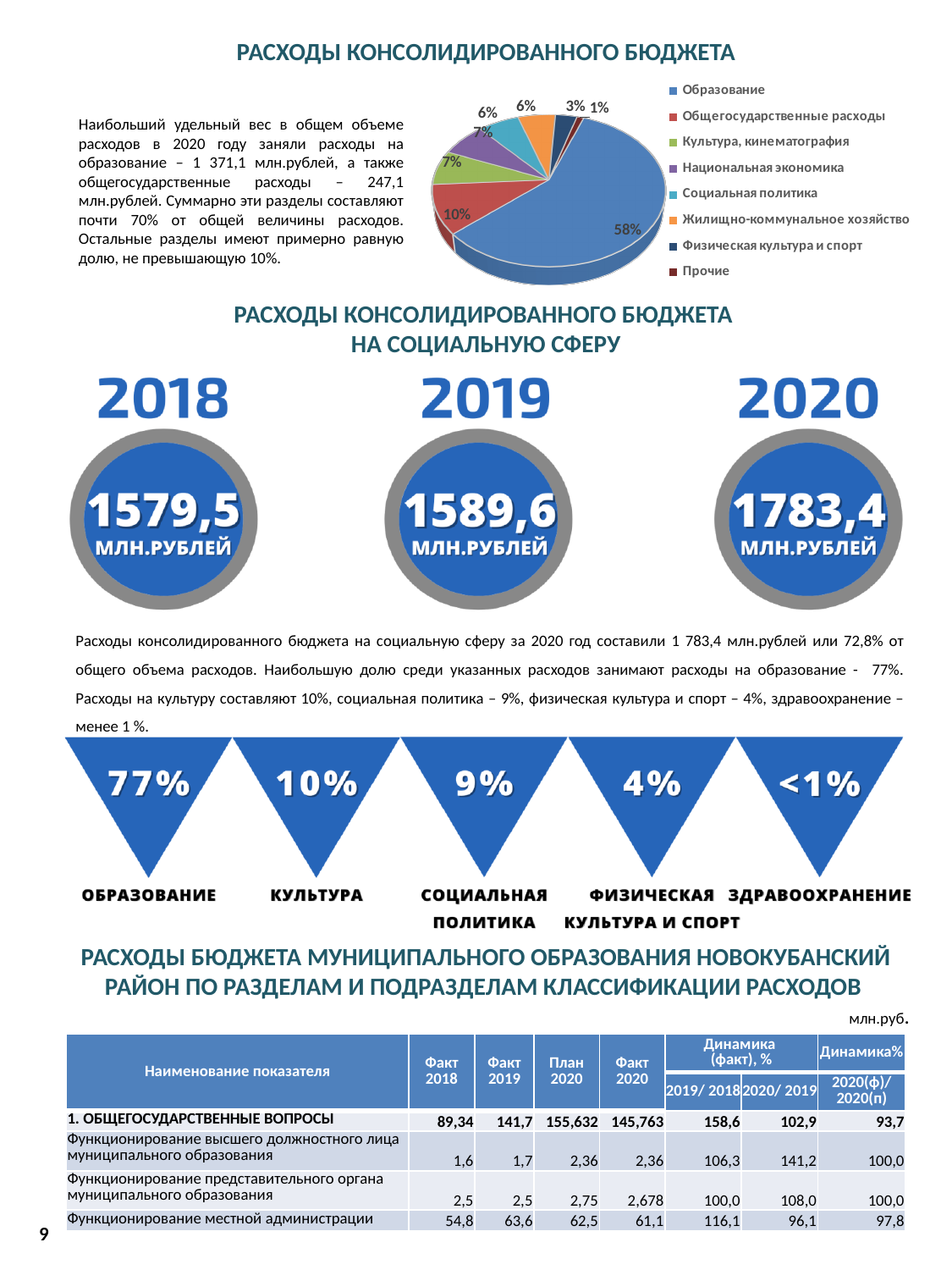
How many categories does the legend of the pie chart 'РАСХОДЫ КОНСОЛИДИРОВАННОГО БЮДЖЕТА' list? 8 In the pie chart 'РАСХОДЫ КОНСОЛИДИРОВАННОГО БЮДЖЕТА', by how many percentage points does the 'Образование' share exceed the 'Общегосударственные расходы' share? 48 percentage points In the pie chart 'РАСХОДЫ КОНСОЛИДИРОВАННОГО БЮДЖЕТА', what share is shown for 'Общегосударственные расходы'? 10% In the pie chart 'РАСХОДЫ КОНСОЛИДИРОВАННОГО БЮДЖЕТА', which is larger: the share for 'Общегосударственные расходы' or for 'Физическая культура и спорт'? Общегосударственные расходы What kind of chart is shown under the title 'РАСХОДЫ КОНСОЛИДИРОВАННОГО БЮДЖЕТА' at the top of the slide? Pie chart In the pie chart 'РАСХОДЫ КОНСОЛИДИРОВАННОГО БЮДЖЕТА', what is the combined share of 'Образование' and 'Общегосударственные расходы'? 68% Which category has the largest slice in the pie chart 'РАСХОДЫ КОНСОЛИДИРОВАННОГО БЮДЖЕТА'? Образование Which category has the smallest slice in the pie chart 'РАСХОДЫ КОНСОЛИДИРОВАННОГО БЮДЖЕТА'? Прочие In the pie chart 'РАСХОДЫ КОНСОЛИДИРОВАННОГО БЮДЖЕТА', what share is shown for 'Образование'? 58% What share of the pie chart 'РАСХОДЫ КОНСОЛИДИРОВАННОГО БЮДЖЕТА' does 'Социальная политика' take? 6% In the pie chart 'РАСХОДЫ КОНСОЛИДИРОВАННОГО БЮДЖЕТА', what colour is the slice for 'Образование'? Blue In the pie chart 'РАСХОДЫ КОНСОЛИДИРОВАННОГО БЮДЖЕТА', what share is shown for 'Физическая культура и спорт'? 3%